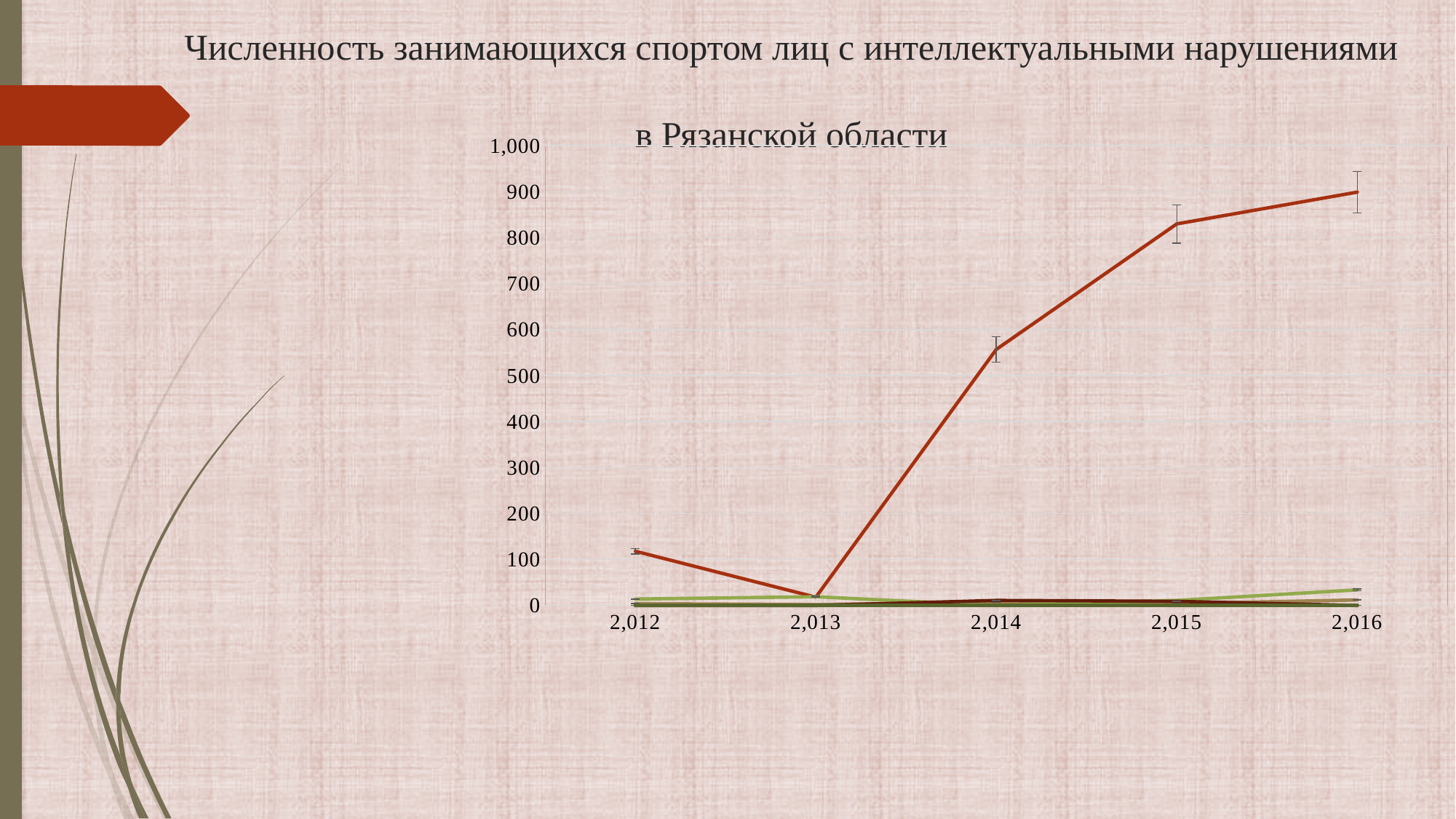
Is the value of the red line in 2,012 greater or less than 200? less Is the value of the red line in 2,014 greater or less than 500? greater Which is larger for the red line: the value in 2,012 or the value in 2,016? 2,016 Is the value of the red line in 2,013 greater or less than 100? less What is the first year shown on the x axis? 2,012 In which year does the red line reach its highest value? 2,016 How many years are shown on the x axis of the chart? 5 What is the last year shown on the x axis? 2,016 Does the red line rise or fall from 2,013 to 2,016? rise In which year does the red line reach its lowest value? 2,013 What kind of chart is shown on the slide? line chart